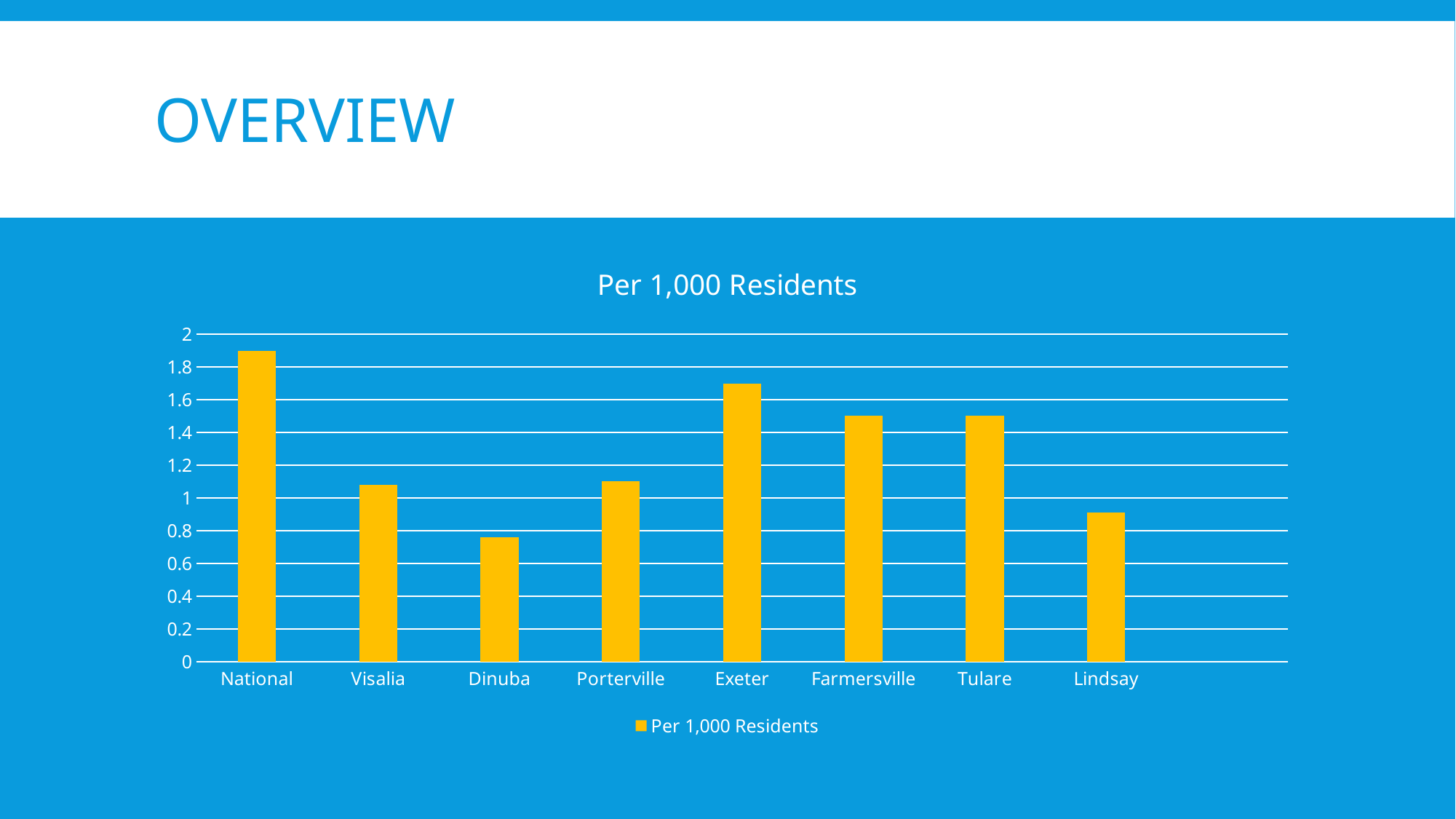
What kind of chart is shown on the slide? bar chart What is the title of the chart? Per 1,000 Residents Which category has the highest value? National Which is larger, the value for National or the value for Exeter? National Is the value for Tulare greater or less than 1.6? less How many series does the legend list? 1 Which category has the lowest value? Dinuba Is the value for Exeter greater or less than 1.6? greater Is the value for National greater or less than 1.8? greater How many categories are shown on the x axis of the chart? 8 Which is larger, the value for Lindsay or the value for Dinuba? Lindsay